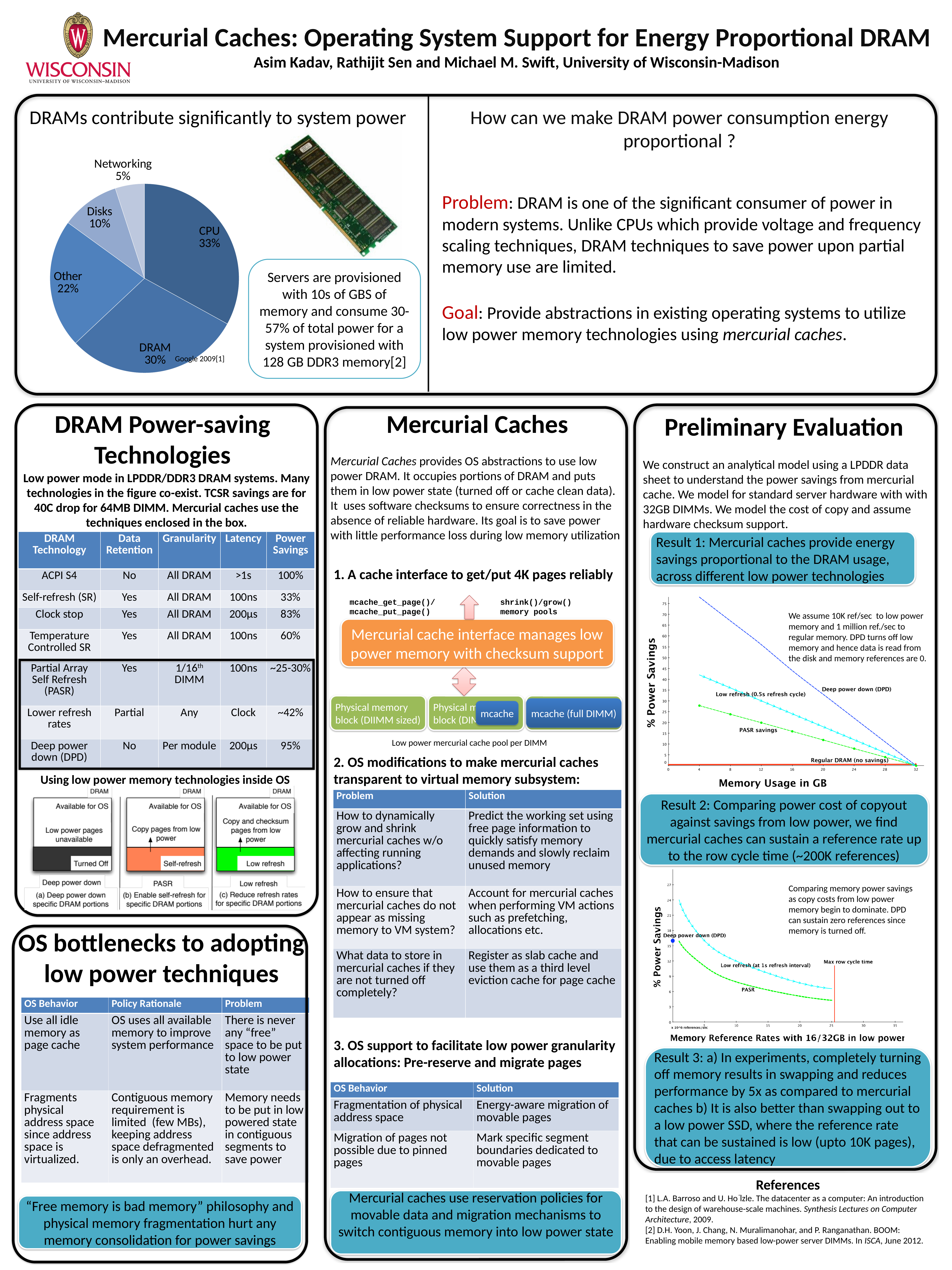
In the pie chart on the left, what is the difference in percentage points between the CPU share and the DRAM share? 3 What kind of chart is used to show the breakdown of system power on the left of the slide? Pie chart In the pie chart on the left, what is the combined share of Disks and Networking? 15% In the upper chart of the Preliminary Evaluation section (% Power Savings vs Memory Usage in GB), do the power savings rise or fall as memory usage increases? Fall How many categories are shown in the pie chart on the left? 5 In the pie chart on the left, what share of system power is attributed to DRAM? 30% In the pie chart on the left, what share of system power is attributed to CPU? 33% In the pie chart on the left, which category has the largest share of system power? CPU In the lower chart of the Preliminary Evaluation section (% Power Savings vs Memory Reference Rates), which line is labelled as the highest at low reference rates? Low refresh (at 1s refresh interval) In the upper chart of the Preliminary Evaluation section, is the % Power Savings for Deep power down (DPD) at 4 GB memory usage greater or less than 60? greater In the pie chart on the left, which is larger: the share for Disks or the share for Other? Other In the pie chart on the left, which category has the smallest share of system power? Networking